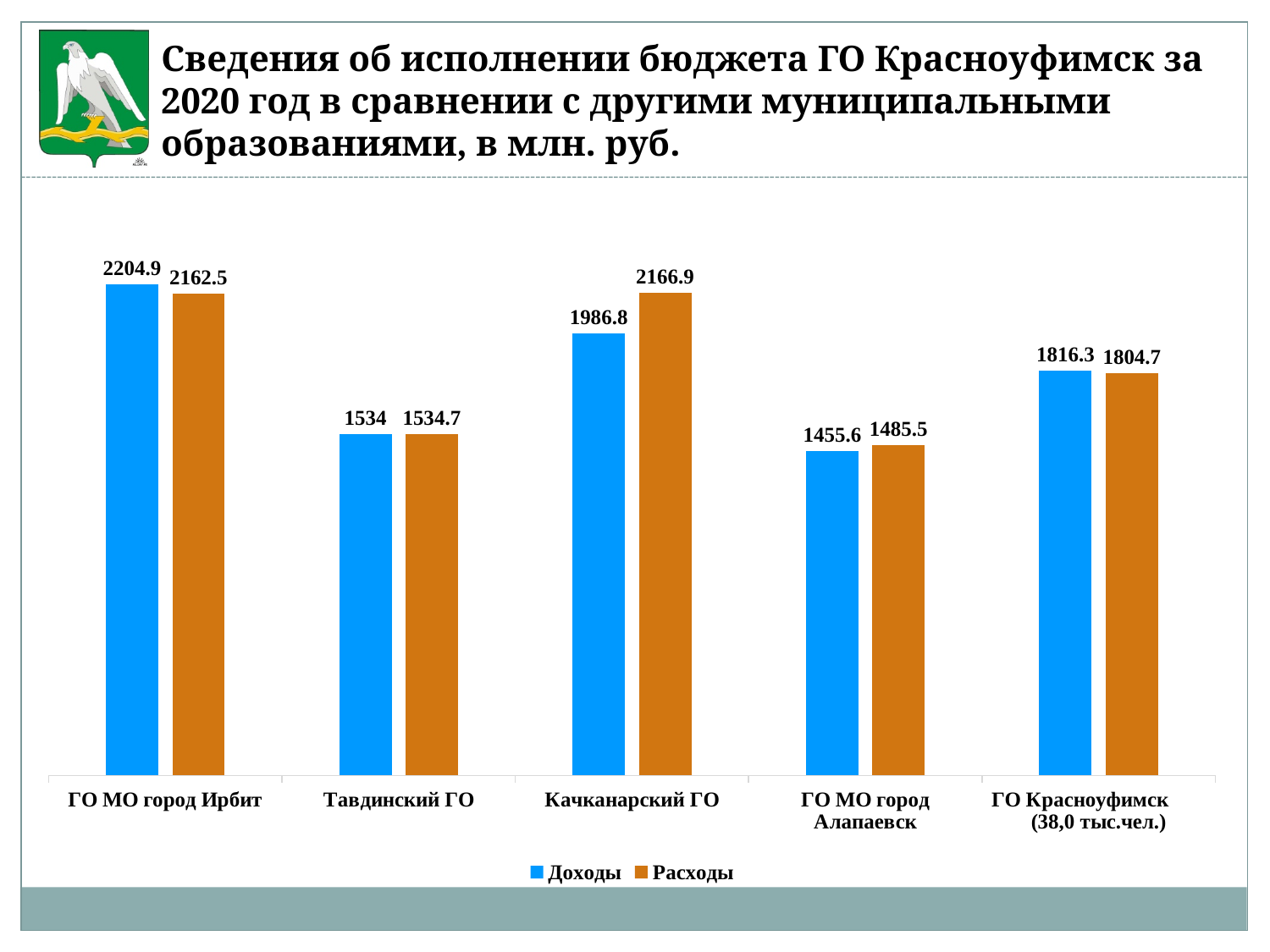
Which municipality has the lowest Расходы? ГО МО город Алапаевск What is the value of Расходы for Качканарский ГО? 2166.9 How many municipalities (categories) are shown on the x axis? 5 What is the difference between Расходы and Доходы for Качканарский ГО? 180.1 How many series does the legend list? 2 What is the value of Доходы for ГО Красноуфимск (38,0 тыс.чел.)? 1816.3 What type of chart is shown on the slide? bar chart What is the value of Расходы for Тавдинский ГО? 1534.7 Which municipality has the highest Доходы? ГО МО город Ирбит What is the value of Доходы for ГО МО город Ирбит? 2204.9 Which colour represents Расходы in the legend? orange For ГО МО город Алапаевск, which is larger: Доходы or Расходы? Расходы